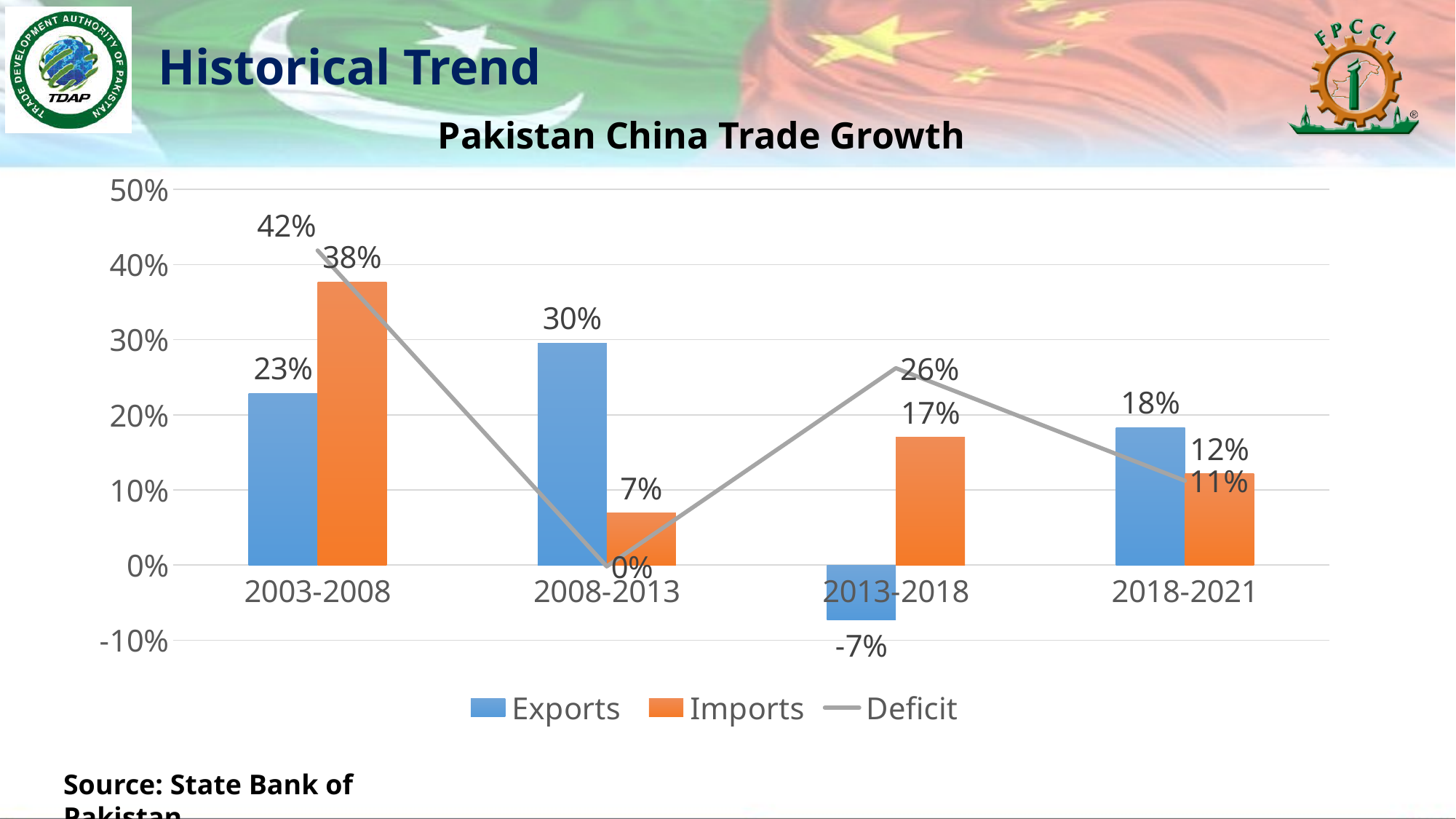
Which period has the lowest Imports value? 2008-2013 What is the Imports value for 2003-2008? 38% Which series is shown as a grey line? Deficit How many periods are shown on the x axis? 4 How many series does the legend list? 3 What kind of chart is this? Combined bar and line chart Which period has the highest Deficit value? 2003-2008 What is the Deficit value for 2013-2018? 26% Which is larger for 2018-2021, Exports or Imports? Exports What is the Exports value for 2008-2013? 30% What is the Exports value for 2013-2018? -7% What is the difference between the Imports and Exports values for 2003-2008? 15%